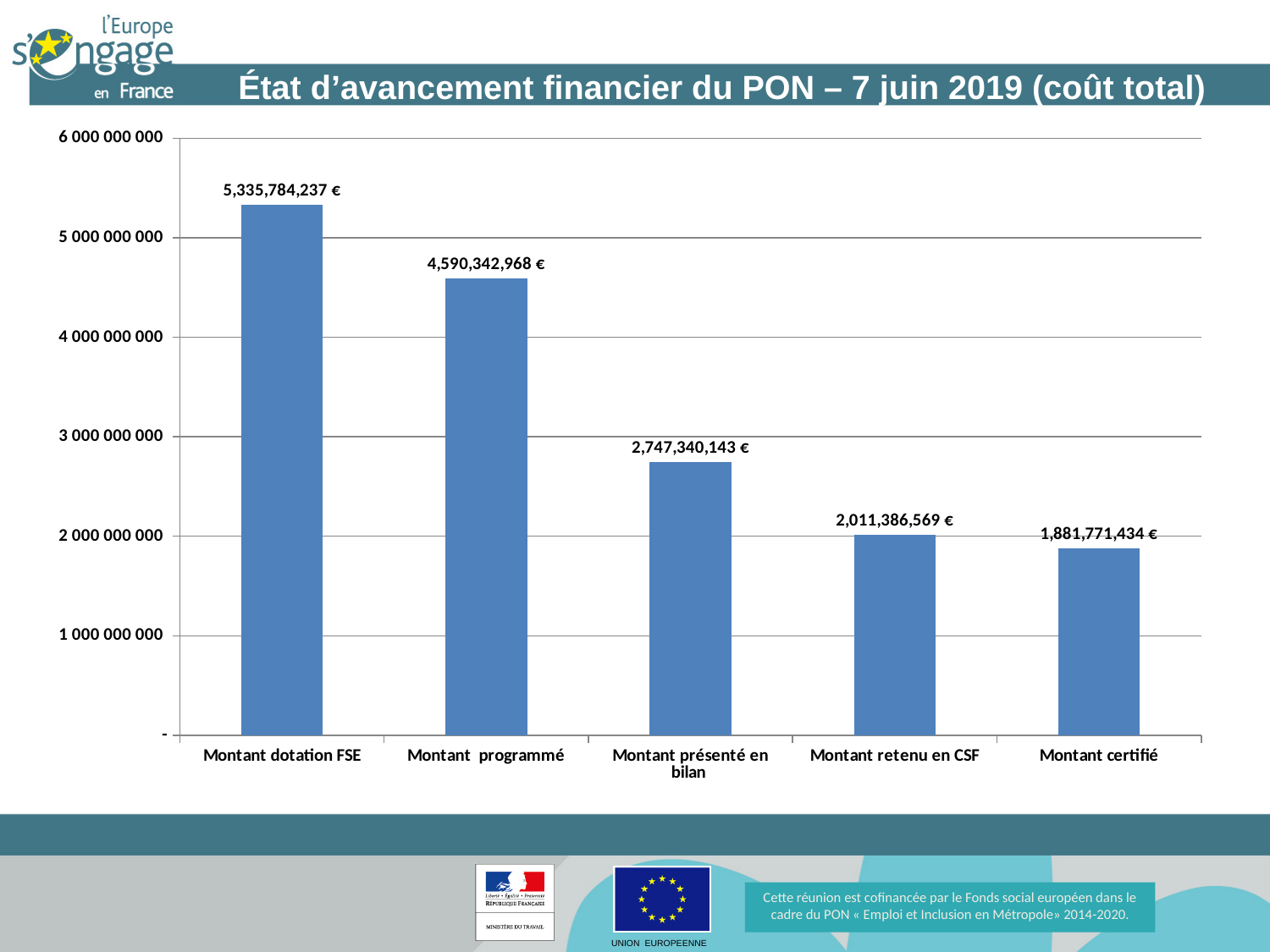
What kind of chart is shown on the slide? bar chart What is the value for Montant dotation FSE? 5,335,784,237 € Which category has the lowest value? Montant certifié Is the value for Montant présenté en bilan greater or less than 3 000 000 000? less What is the value for Montant certifié? 1,881,771,434 € Do the values rise or fall from left to right along the x axis? fall What is the difference between Montant dotation FSE and Montant programmé? 745,441,269 € How many categories are shown on the x axis? 5 Which category has the highest value? Montant dotation FSE What is the difference between Montant retenu en CSF and Montant certifié? 129,615,135 € Which is larger, Montant programmé or Montant présenté en bilan? Montant programmé What is the value for Montant présenté en bilan? 2,747,340,143 €